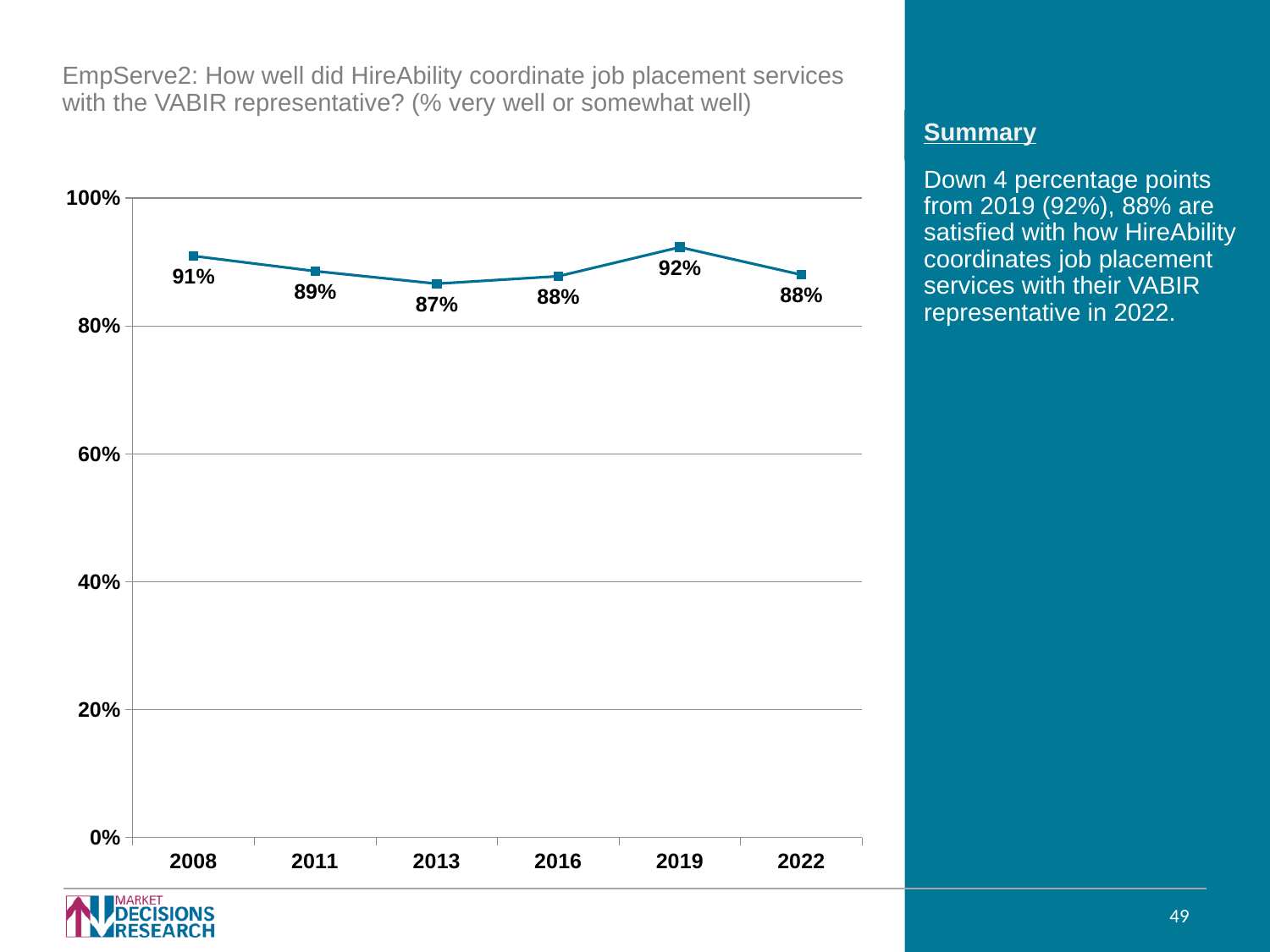
Which is larger, the value for 2008 or the value for 2011? 2008 Does the value rise or fall from 2019 to 2022? Fall Which year has the highest value? 2019 What is the difference between the values for 2019 and 2022? 4 percentage points What kind of chart is shown on the slide? Line chart What is the value for 2022? 88% How many years are plotted on the chart? 6 What is the value for 2019? 92% Is the value for 2016 greater or less than 80%? greater What is the value for 2008? 91% What is the value for 2013? 87% Which year has the lowest value? 2013